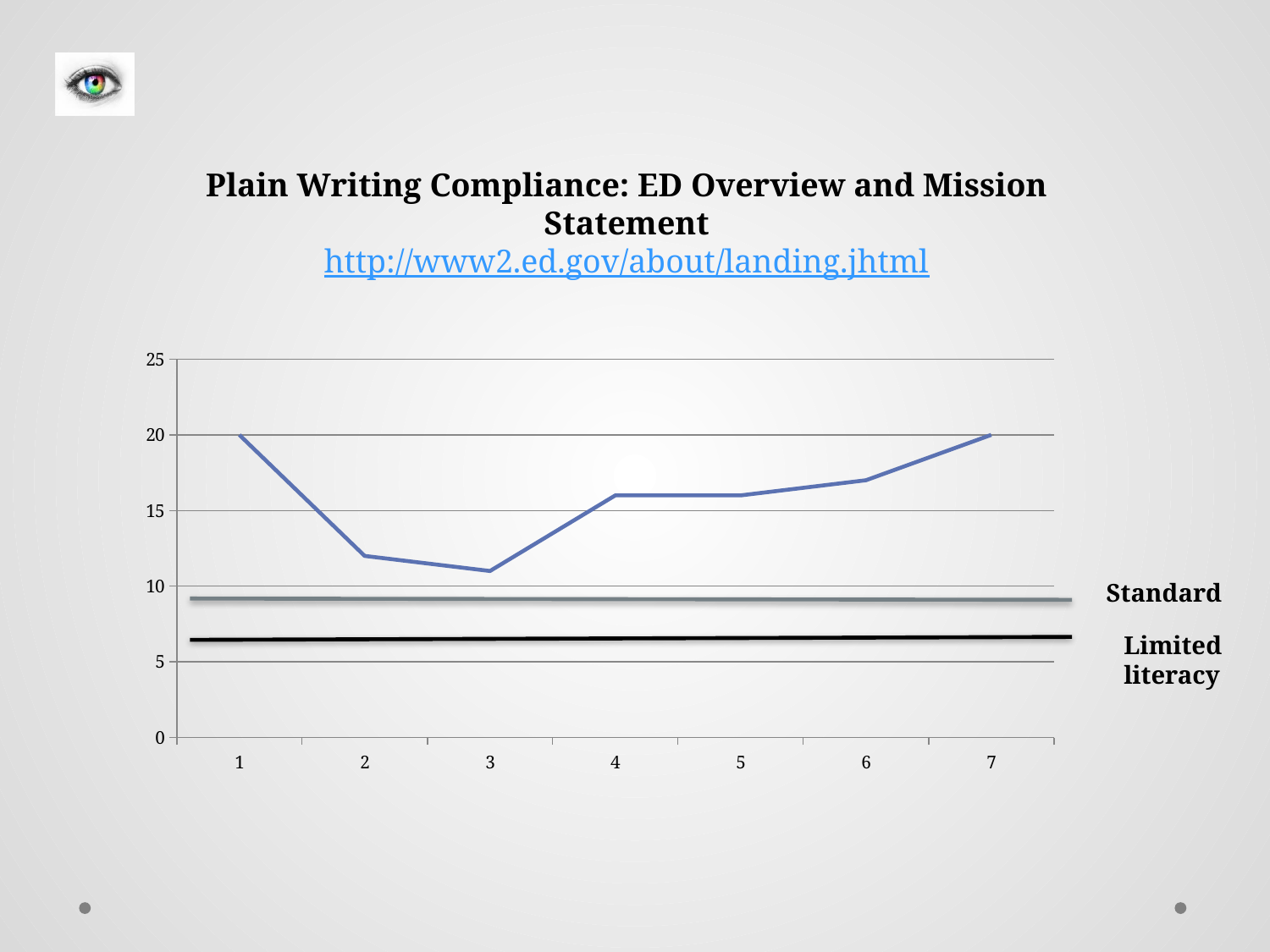
What are the two labelled reference lines on the chart called? Standard and Limited literacy What is the value of the blue line at x = 7? 20 Is the Standard line greater or less than 10? less What is the value of the blue line at x = 1? 20 Is the value of the blue line at x = 4 greater or less than 15? greater At which x value does the blue line reach its lowest point? 3 Does the blue line rise or fall from x = 3 to x = 7? rise How many points are plotted along the x axis of the blue line? 7 What kind of chart is shown on the slide? line chart Which is larger, the blue line's value at x = 1 or at x = 3? x = 1 Is the Limited literacy line greater or less than 5? greater